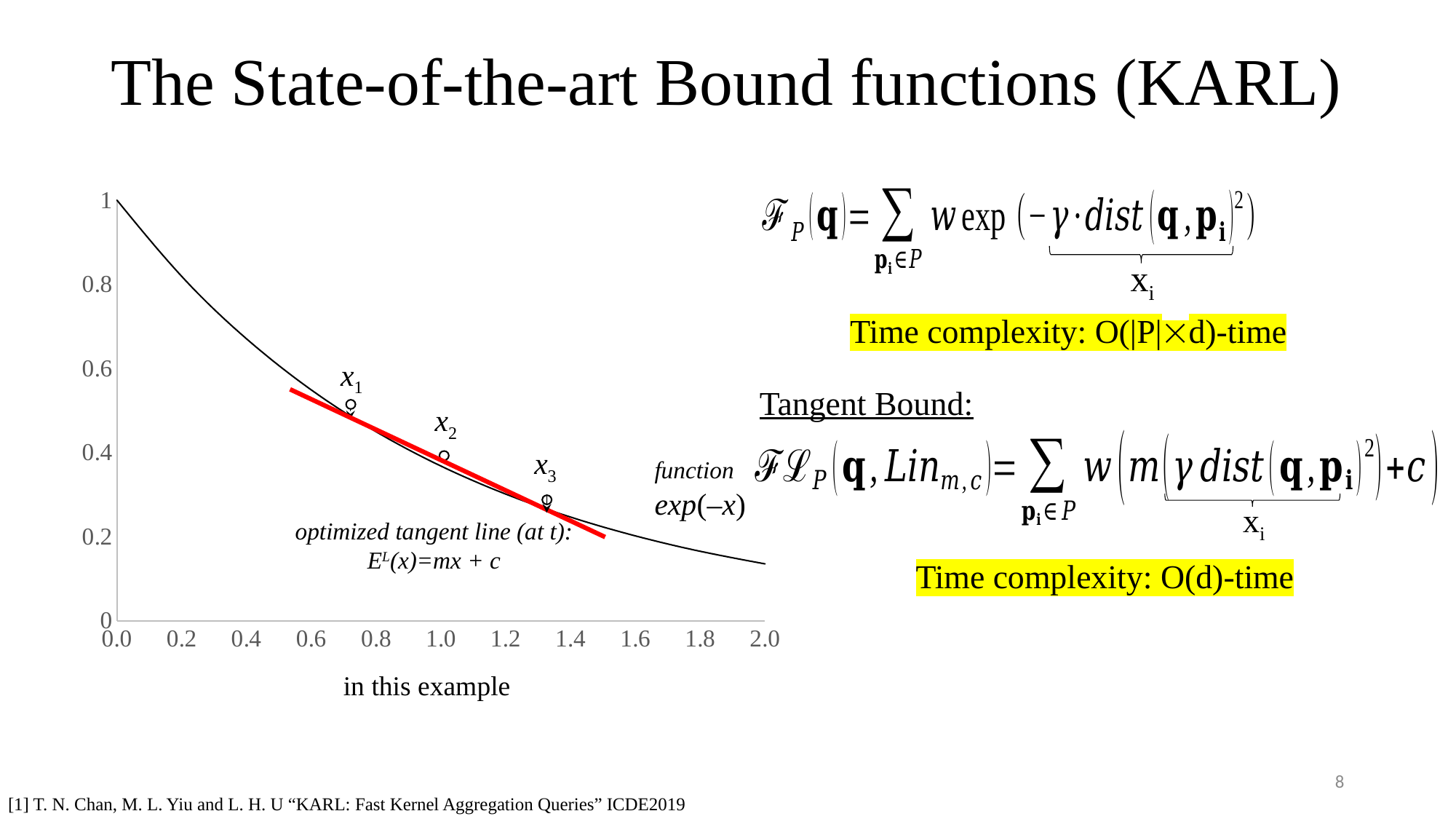
Does the plotted curve rise or fall as x increases from 0.0 to 2.0? fall What is the value of the curve at x = 0.0? 1 What kind of chart is shown on the left of the slide? line chart Which function is plotted as the black curve in the chart? exp(–x) Is the curve value at the point x1 greater or less than 0.4? greater Which of the marked points x1, x2, x3 has the lowest value on the curve? x3 Which has the larger curve value, x1 or x3? x1 Which of the marked points x1, x2, x3 has the highest value on the curve? x1 What does the red line in the chart represent? optimized tangent line (at t): E^L(x)=mx + c How many labelled points (x1, x2, x3) are marked on the curve? 3 Is the curve value at the point x2 greater or less than 0.2? greater Is the curve value at the point x3 greater or less than 0.4? less